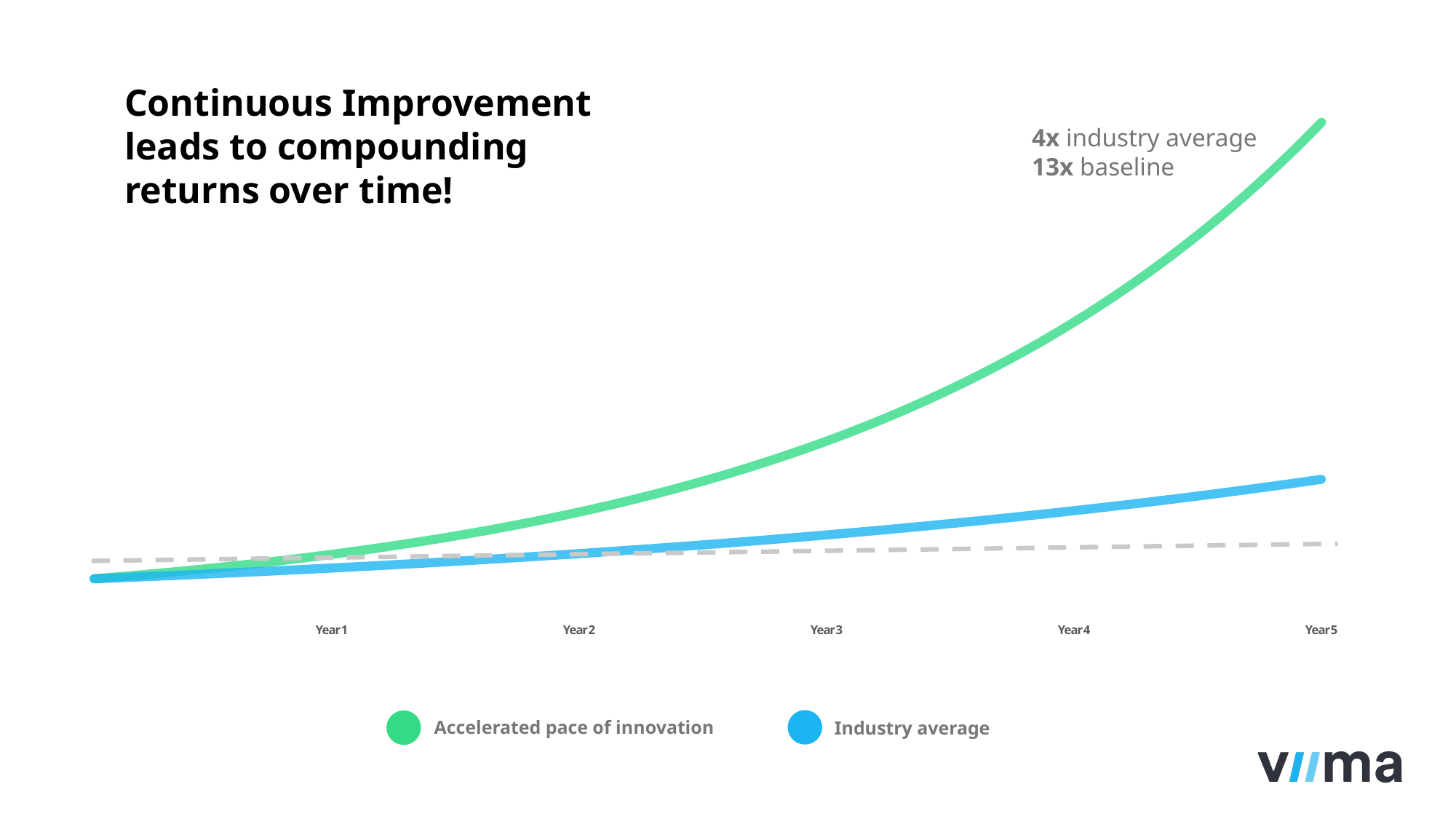
What colour is the Industry average line? blue How many series does the legend list? 2 Which series is higher at Year 5, Accelerated pace of innovation or Industry average? Accelerated pace of innovation Which of the two legend series has the lowest value at Year 5? Industry average According to the annotation, how many times the industry average does the accelerated pace of innovation reach? 4x Does the Industry average line rise or fall from Year 1 to Year 5? rise What is the last category label on the x axis? Year 5 What is the first category label on the x axis? Year 1 Which series reaches the highest value on the chart? Accelerated pace of innovation What kind of chart is shown on the slide? line chart How many year categories are shown on the x axis? 5 Does the Accelerated pace of innovation line rise or fall from Year 1 to Year 5? rise